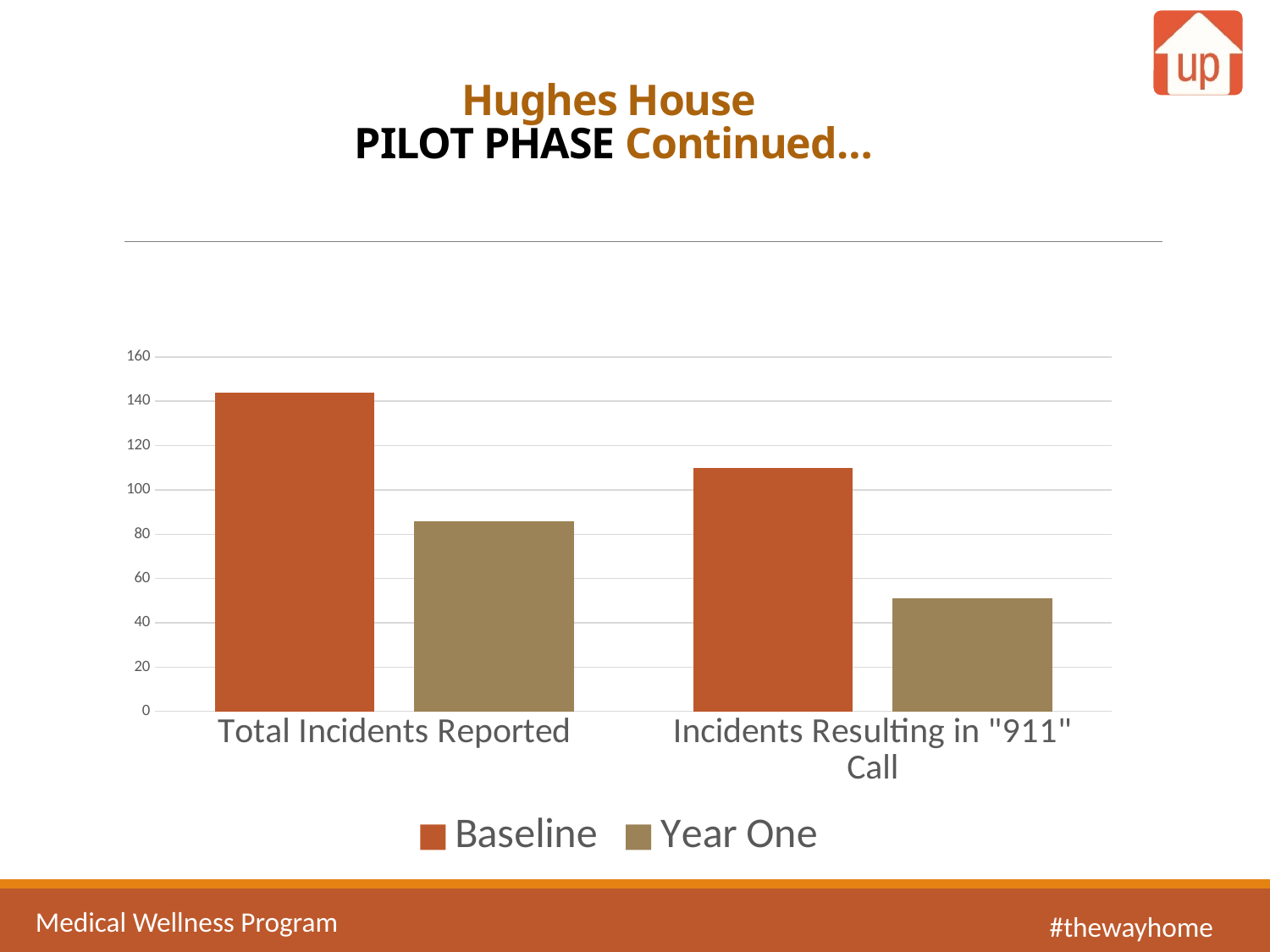
Is the Year One value for Total Incidents Reported greater or less than 100? less For Incidents Resulting in "911" Call, which is larger: the Baseline value or the Year One value? Baseline Is the Baseline value for Incidents Resulting in "911" Call greater or less than 100? greater What kind of chart is shown on the slide? bar chart Is the Baseline value for Total Incidents Reported greater or less than 120? greater What are the two series names listed in the chart legend? Baseline and Year One Which series and category has the tallest bar in the chart? Baseline, Total Incidents Reported How many series does the chart legend list? 2 How many categories are shown on the x axis of the chart? 2 Which series and category has the shortest bar in the chart? Year One, Incidents Resulting in "911" Call Which is larger: the Year One value for Total Incidents Reported or the Year One value for Incidents Resulting in "911" Call? Total Incidents Reported